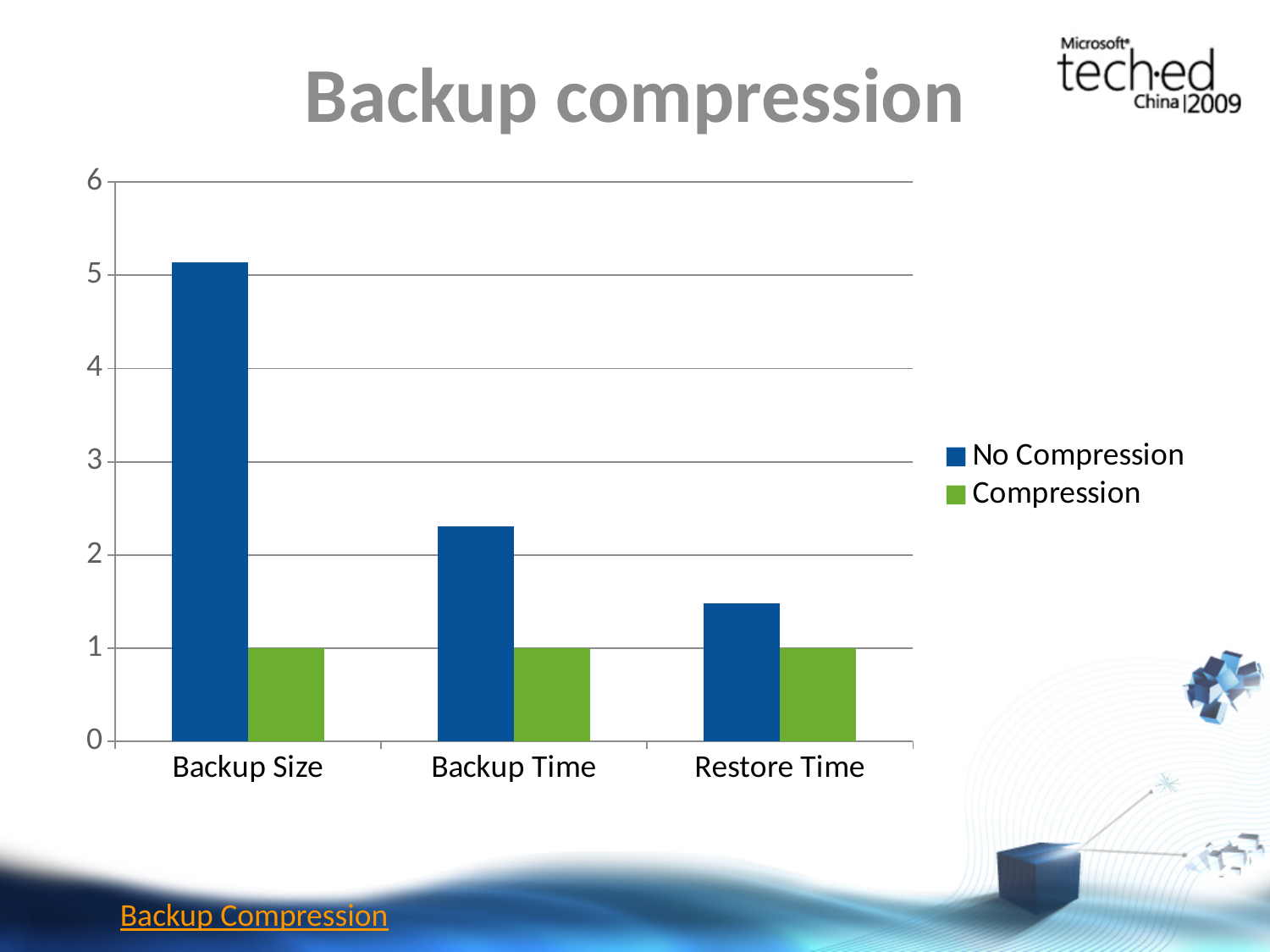
How many categories are shown on the x axis? 3 What is the value of the Compression bar for Restore Time? 1 Is the No Compression value for Restore Time greater or less than 2? less For Backup Time, which is larger: No Compression or Compression? No Compression Which category has the lowest No Compression value? Restore Time What kind of chart is shown on the slide? bar chart What is the value of the Compression bar for Backup Size? 1 Is the No Compression value for Backup Size greater or less than 4? greater Which category has the highest No Compression value? Backup Size How many series does the legend list? 2 Is the No Compression value for Backup Time greater or less than 3? less Do the No Compression values rise or fall from Backup Size to Restore Time? fall